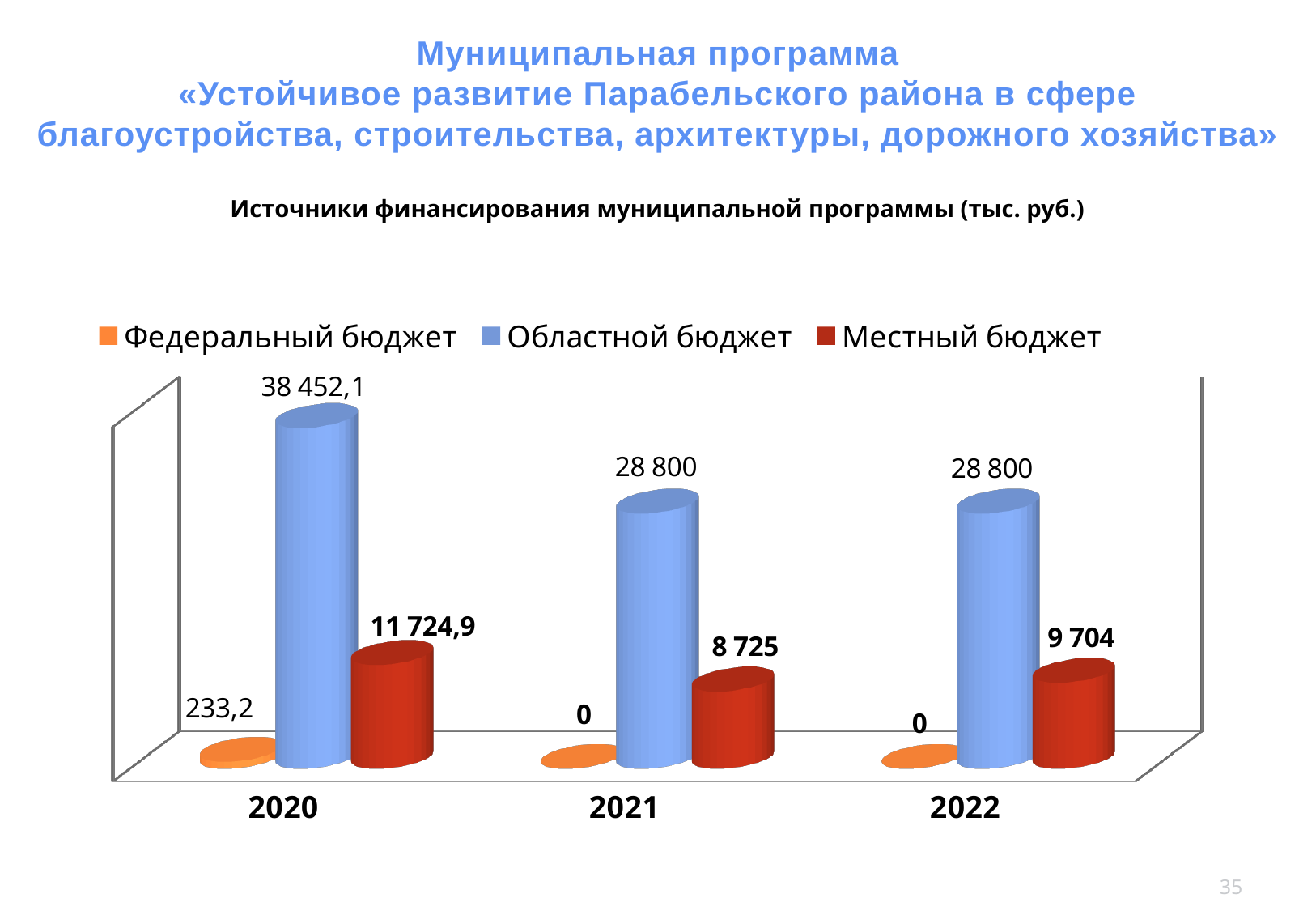
What is the difference between Местный бюджет in 2022 and in 2021? 979 What is the value for Местный бюджет in 2022? 9 704 Which is larger: Местный бюджет in 2020 or Местный бюджет in 2022? Местный бюджет in 2020 What is the value for Местный бюджет in 2021? 8 725 In which year is Областной бюджет highest? 2020 In which year is Местный бюджет lowest? 2021 What is the value for Областной бюджет in 2020? 38 452,1 What is the value for Федеральный бюджет in 2022? 0 How many series does the legend list? 3 What is the value for Федеральный бюджет in 2020? 233,2 What is the difference between Областной бюджет in 2020 and in 2021? 9 652,1 What kind of chart is shown on the slide? Bar chart